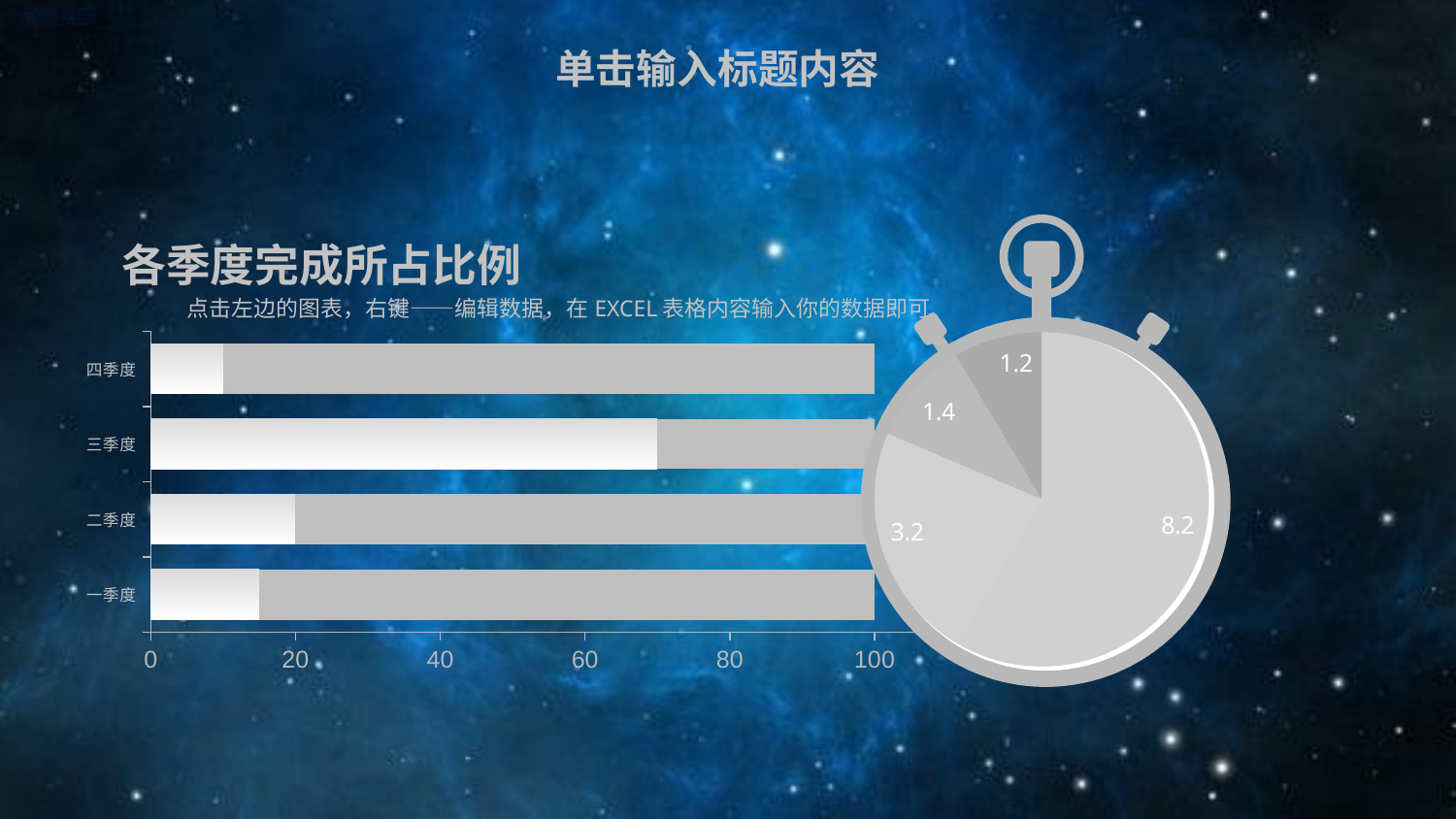
What is the difference between the largest slice (8.2) and the slice labelled 3.2 in the pie chart inside the stopwatch? 5.0 How many slices does the pie chart inside the stopwatch have? 4 What is the title of the bar chart on the left? 各季度完成所占比例 In the bar chart on the left, is the light-grey bar for 三季度 greater or less than 60? greater In the bar chart on the left, is the light-grey bar for 四季度 greater or less than 20? less In the bar chart on the left, which quarter has the longest light-grey bar? 三季度 In the bar chart on the left, is the light-grey bar for 三季度 longer or shorter than the one for 二季度? longer How many categories does the bar chart on the left show? 4 In the bar chart on the left, is the light-grey bar for 一季度 greater or less than 20? less What kind of chart is the chart on the left of the slide? bar chart What is the value of the largest slice in the pie chart inside the stopwatch? 8.2 What kind of chart is shown inside the stopwatch on the right? pie chart